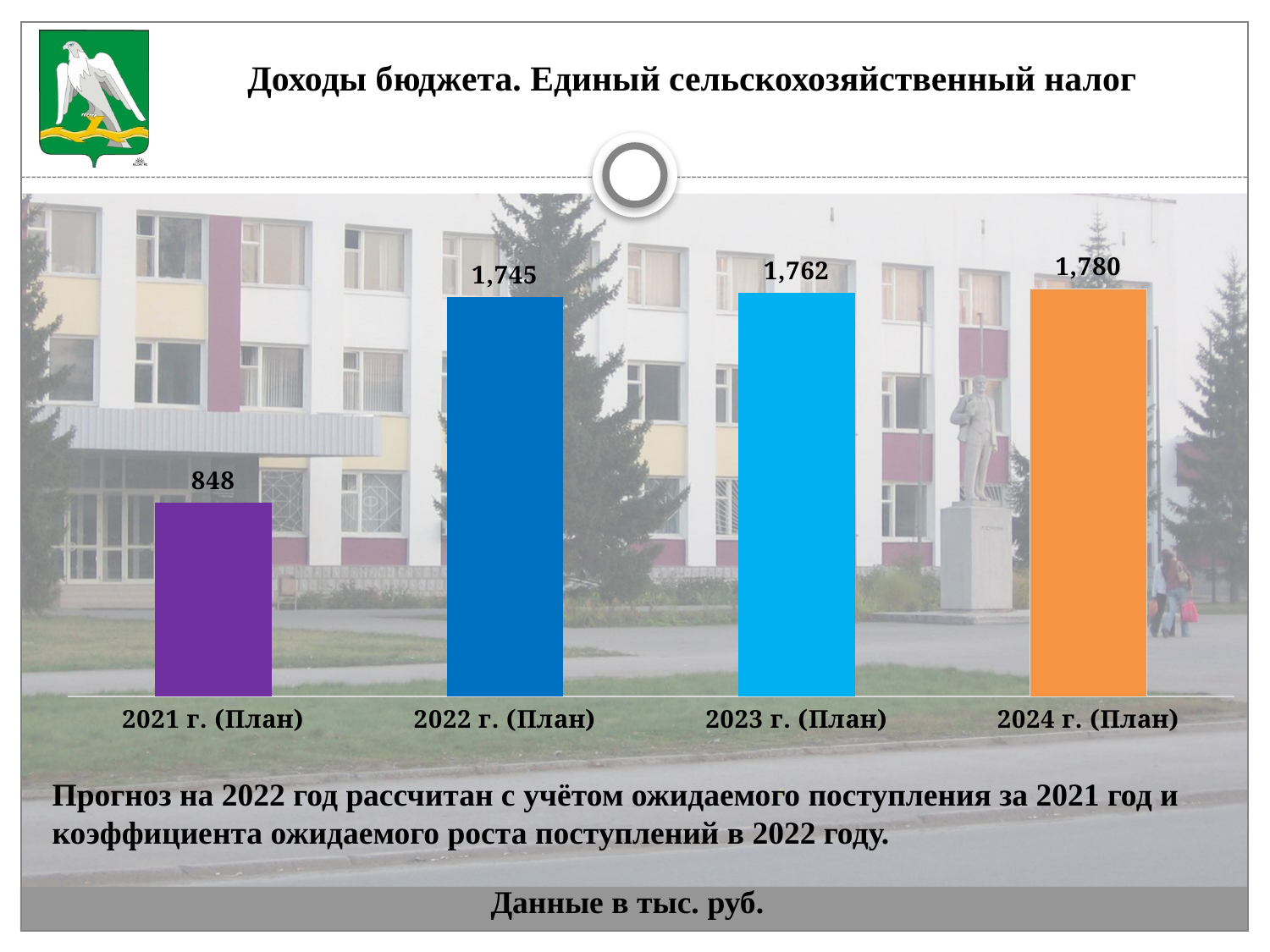
Which is larger, the value for 2021 г. (План) or the value for 2022 г. (План)? 2022 г. (План) What is the value for 2021 г. (План)? 848 What is the value for 2023 г. (План)? 1,762 What is the value for 2024 г. (План)? 1,780 What kind of chart is shown on the slide? Bar chart Do the values rise or fall from 2021 г. (План) to 2024 г. (План)? Rise What is the value for 2022 г. (План)? 1,745 How many categories are shown on the chart? 4 What is the difference between the values for 2022 г. (План) and 2021 г. (План)? 897 What is the difference between the values for 2024 г. (План) and 2023 г. (План)? 18 Which category has the lowest value? 2021 г. (План) Which category has the highest value? 2024 г. (План)